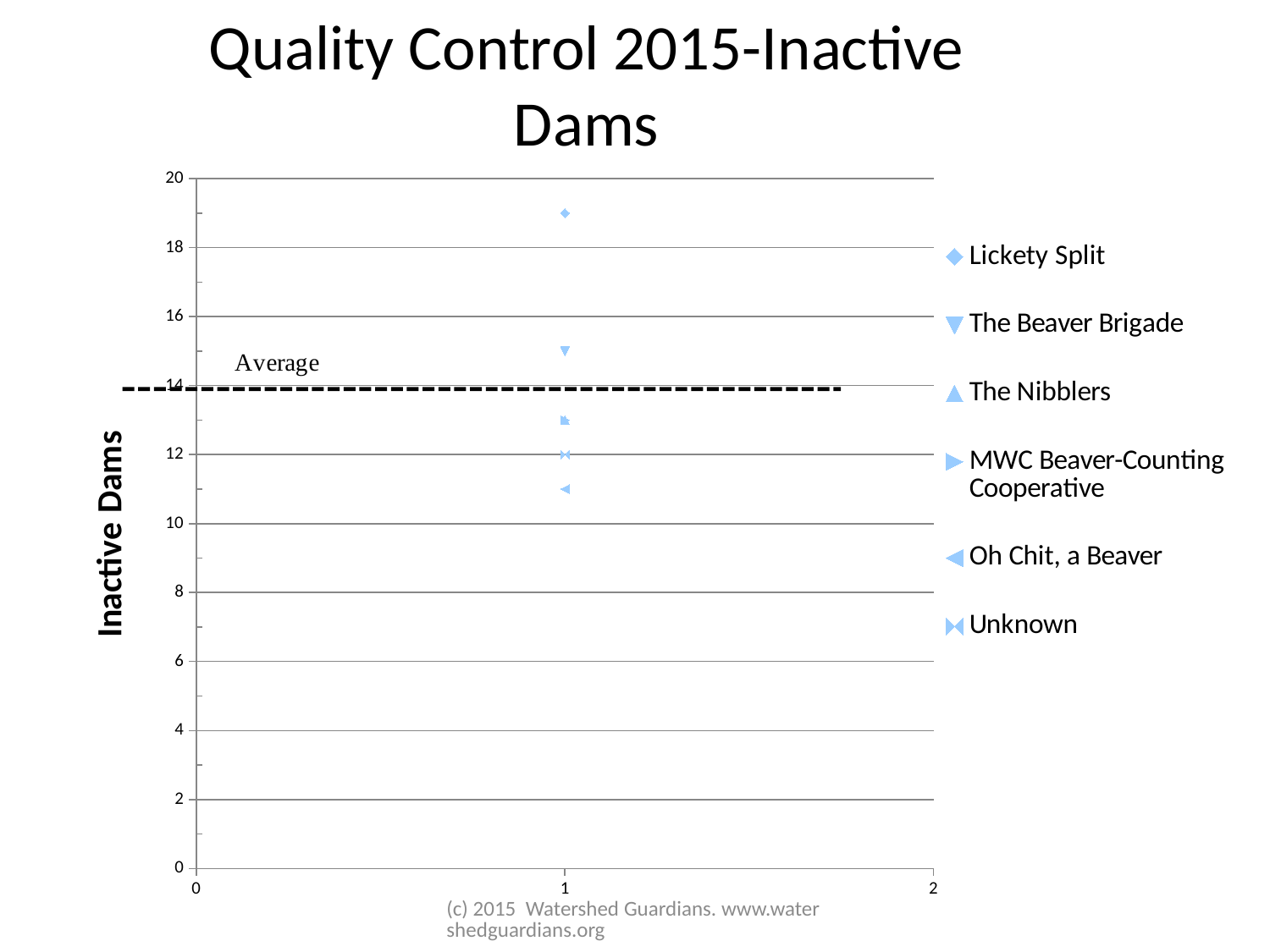
What does the dashed horizontal line on the chart represent? Average What kind of chart is shown on the slide? Scatter chart Which has more inactive dams, The Beaver Brigade or Oh Chit, a Beaver? The Beaver Brigade Which has more inactive dams, Lickety Split or The Beaver Brigade? Lickety Split Is the value for Lickety Split greater or less than 18? greater Which series has the lowest number of inactive dams? Oh Chit, a Beaver Is the value for Oh Chit, a Beaver greater or less than 12? less What is the title of the chart? Quality Control 2015-Inactive Dams Is the value for The Beaver Brigade greater or less than 14? greater Which series has the highest number of inactive dams? Lickety Split How many series does the legend list? 6